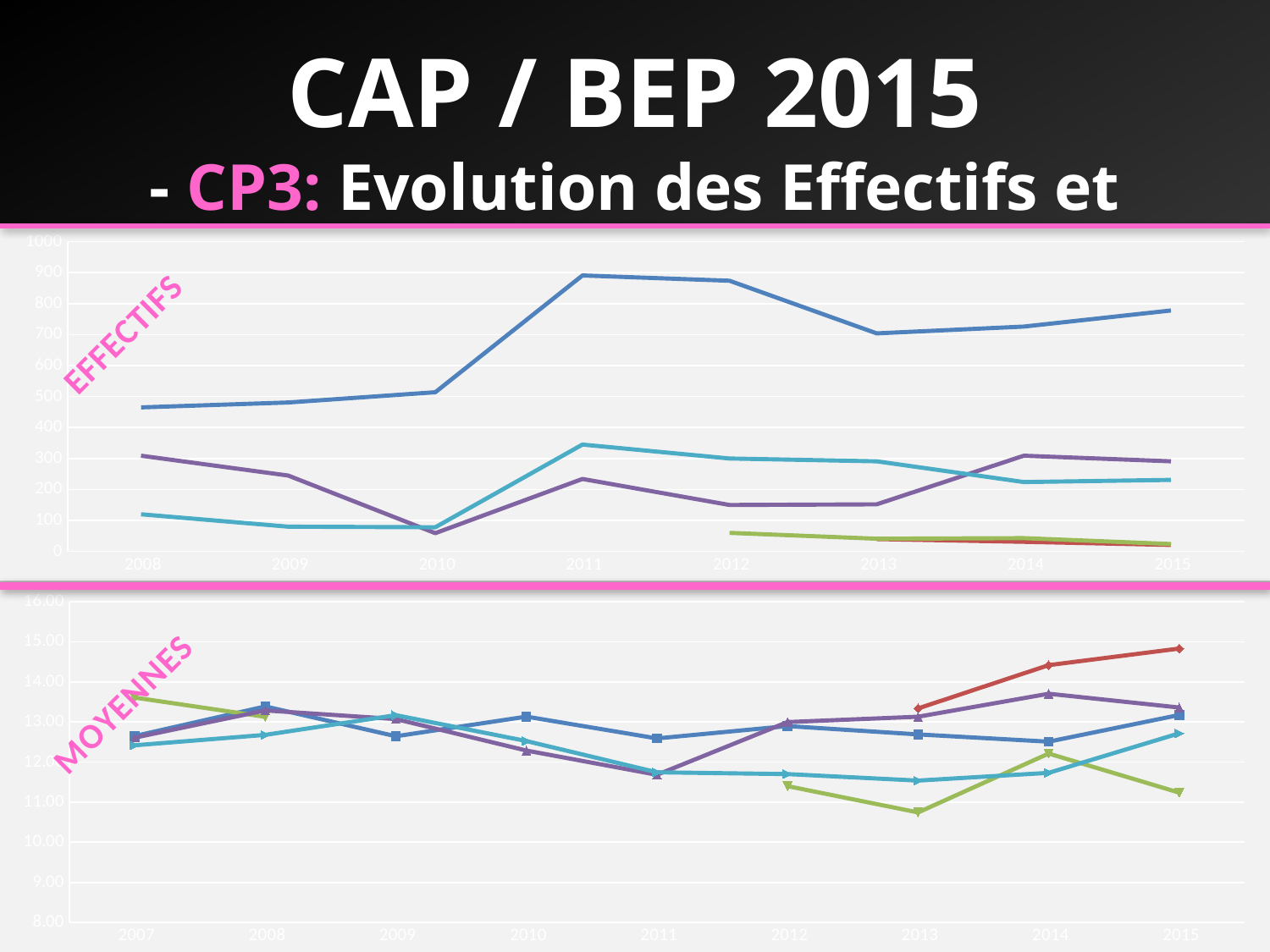
In the top chart (EFFECTIFS), is the value of the blue line in 2008 greater or less than 500? less How many years are shown on the x axis of the top chart (EFFECTIFS)? 8 What kind of chart is the top chart labelled EFFECTIFS? line chart In the bottom chart (MOYENNES), is the value of the red line in 2015 greater or less than 14.00? greater In the bottom chart (MOYENNES), is the value of the green line in 2013 greater or less than 11.00? less How many years are shown on the x axis of the bottom chart (MOYENNES)? 9 What is the highest value shown on the y axis of the top chart (EFFECTIFS)? 1000 In the top chart (EFFECTIFS), does the blue line rise or fall from 2013 to 2015? rise In the top chart (EFFECTIFS), in which year does the blue line reach its highest value? 2011 In the top chart (EFFECTIFS), in which year does the purple line reach its lowest value? 2010